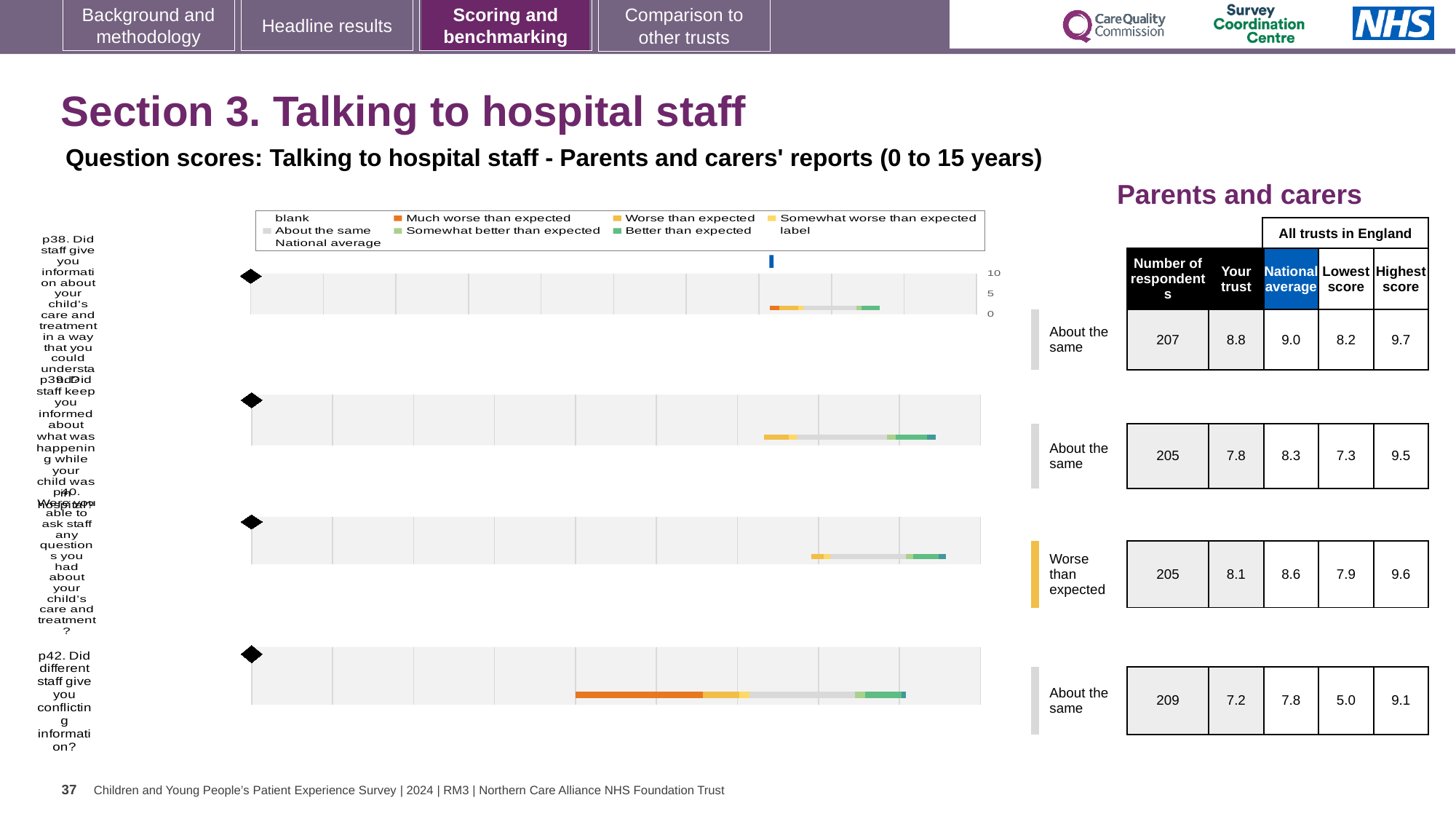
Which question has the highest 'Your trust' score? p38 For question p39, which is larger: the 'Your trust' score or the national average? National average Which colour in the chart legend represents 'Much worse than expected'? orange What is the difference between the national average and the 'Your trust' score for question p38? 0.2 How many survey questions (categories) are plotted in the chart? 4 What is the national average score for question p42 (Did different staff give you conflicting information?)? 7.8 What kind of chart is used to show the question scores on this slide? bar chart Which benchmark category is shown for question p40 (Were you able to ask staff any questions you had about your child's care and treatment?)? Worse than expected Which question has the lowest 'Your trust' score? p42 What is the title of the chart section above the table on the right? Parents and carers How many respondents answered question p39 (Did staff keep you informed about what was happening while your child was in hospital?)? 205 What is the 'Your trust' score for question p38 (Did staff give you information about your child's care and treatment in a way that you could understand?)? 8.8